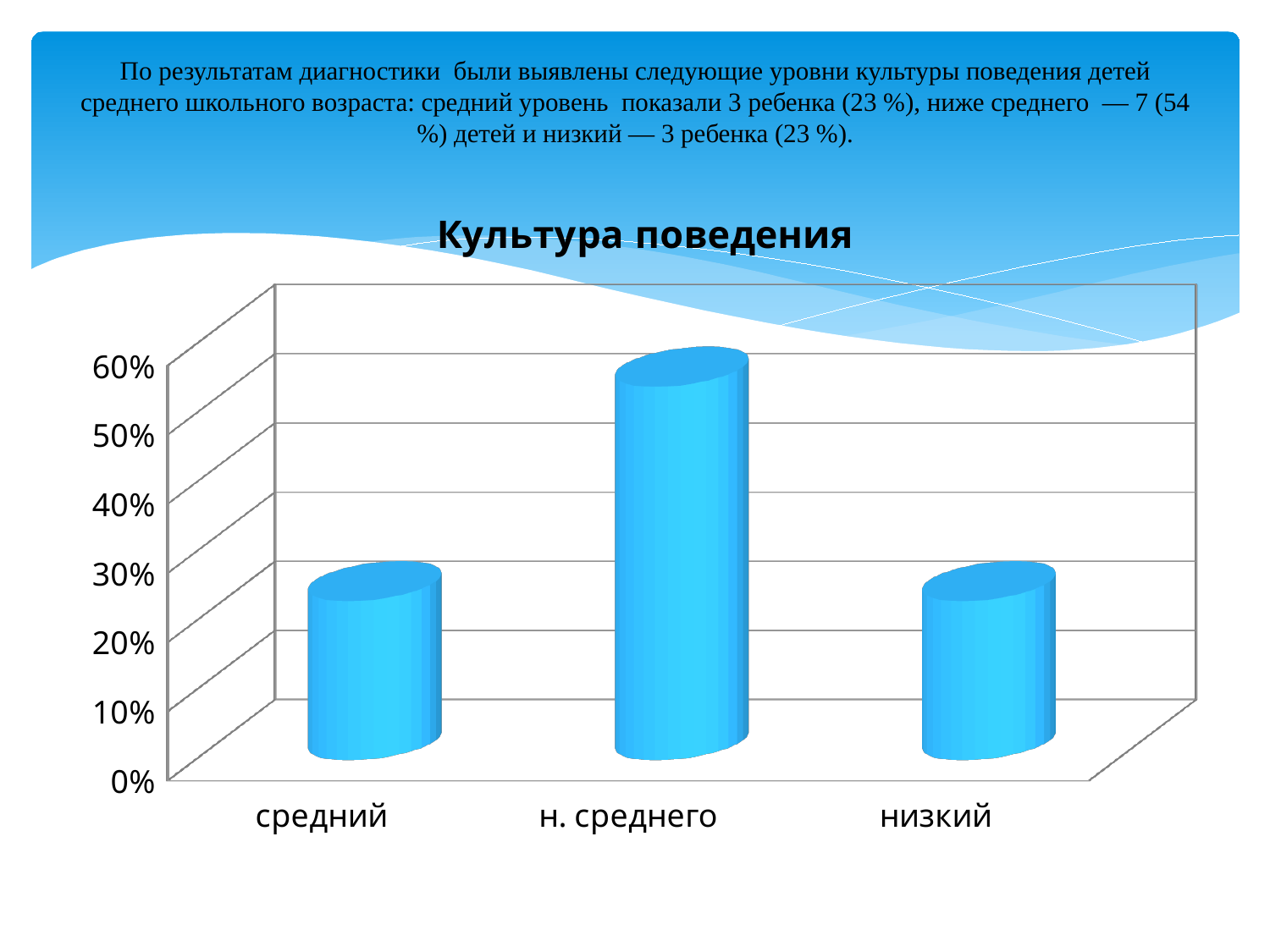
Is the value for средний greater or less than 30%? less What kind of chart is shown on the slide? bar chart Is the value for средний greater or less than 10%? greater Which is larger, the value for низкий or the value for н. среднего? н. среднего How many categories are shown on the x axis of the chart? 3 Is the value for н. среднего greater or less than 50%? greater Which is larger, the value for н. среднего or the value for средний? н. среднего What is the title of the chart? Культура поведения Which category has the highest bar in the chart? н. среднего What colour are the bars in the chart? blue